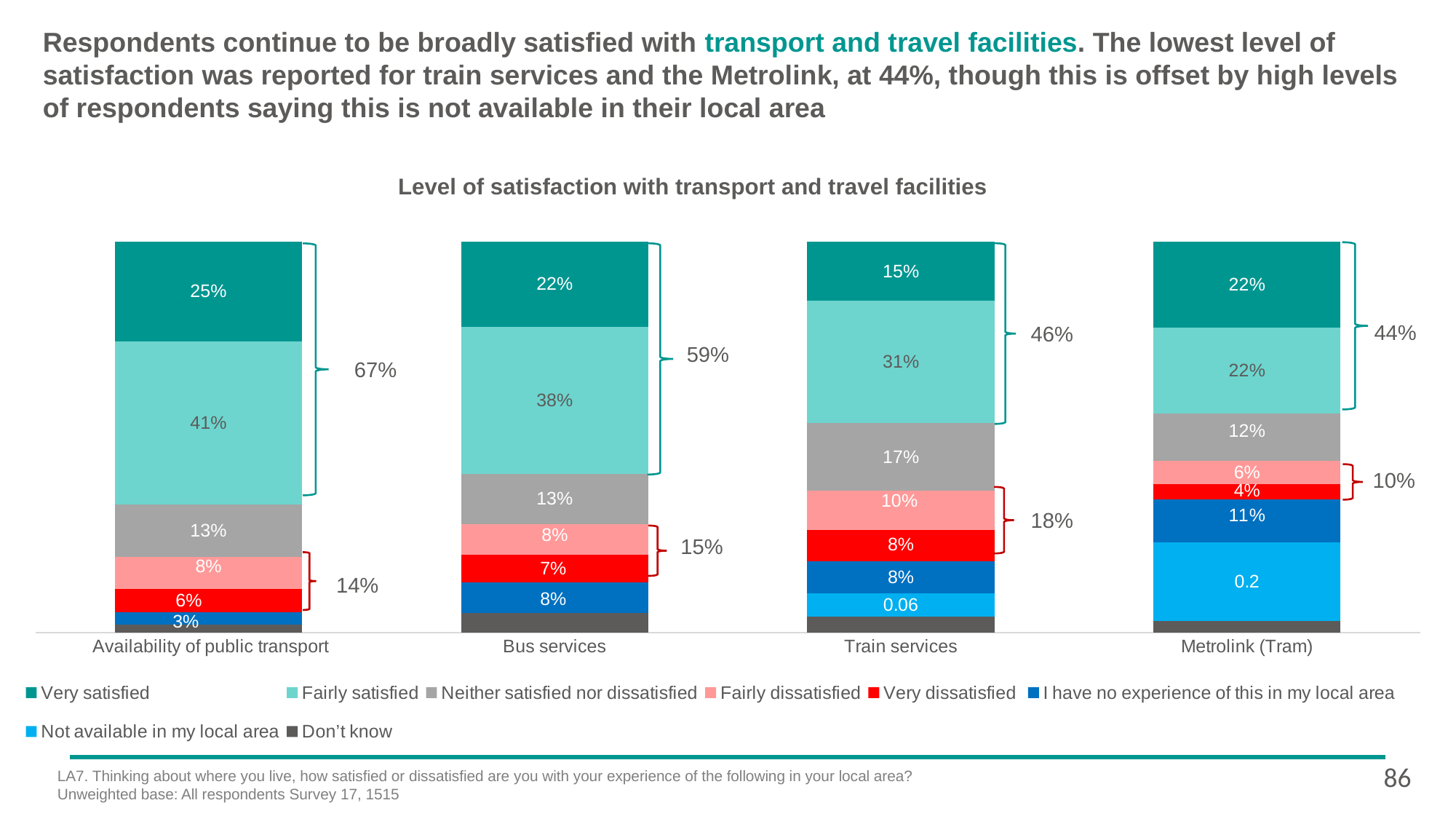
What is the difference between the 'Very satisfied' values for Availability of public transport and Train services? 10 percentage points What is the 'Very satisfied' value for Bus services? 22% How many series does the chart's legend list? 8 What is the title of the chart? Level of satisfaction with transport and travel facilities What kind of chart is shown on the slide? Stacked bar chart What is the 'Fairly satisfied' value for Train services? 31% What is the 'Very dissatisfied' value for Metrolink (Tram)? 4% Which is larger, the 'Neither satisfied nor dissatisfied' value for Train services or for Bus services? Train services Which category has the lowest 'Very satisfied' value? Train services What is the 'Not available in my local area' value shown for Metrolink (Tram)? 0.2 Which category has the highest 'Fairly satisfied' value? Availability of public transport How many categories are shown along the x axis of the chart? 4